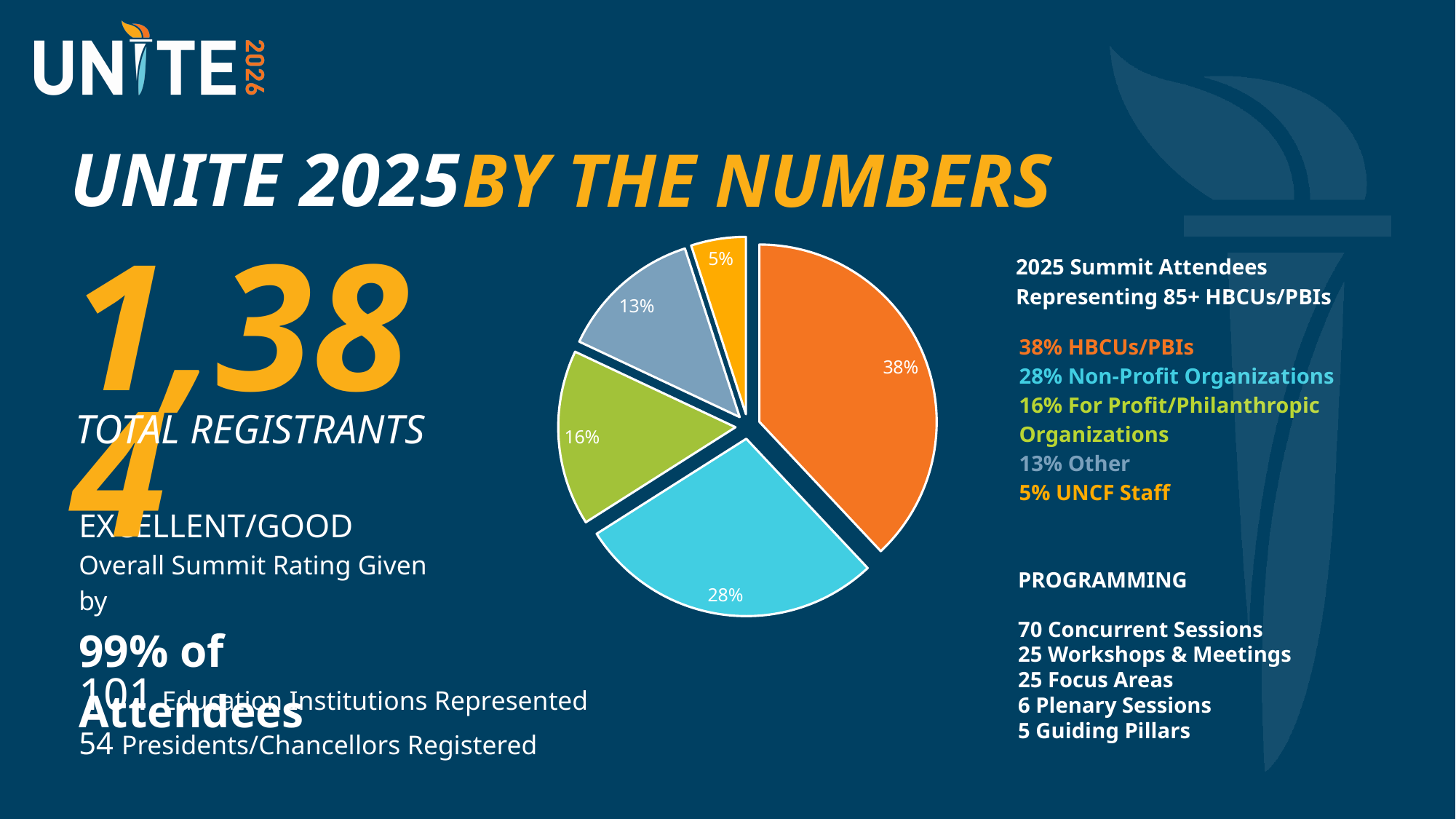
What kind of chart is shown on the slide? pie chart Which slice is larger: For Profit/Philanthropic Organizations or Other? For Profit/Philanthropic Organizations What share of the pie chart is Other? 13% What share of the pie chart is Non-Profit Organizations? 28% What share of the pie chart is HBCUs/PBIs? 38% How many slices does the pie chart have? 5 Which category has the largest slice of the pie chart? HBCUs/PBIs Which category has the smallest slice of the pie chart? UNCF Staff What colour is the HBCUs/PBIs slice of the pie chart? orange What is the difference in percentage points between the HBCUs/PBIs slice and the Non-Profit Organizations slice? 10